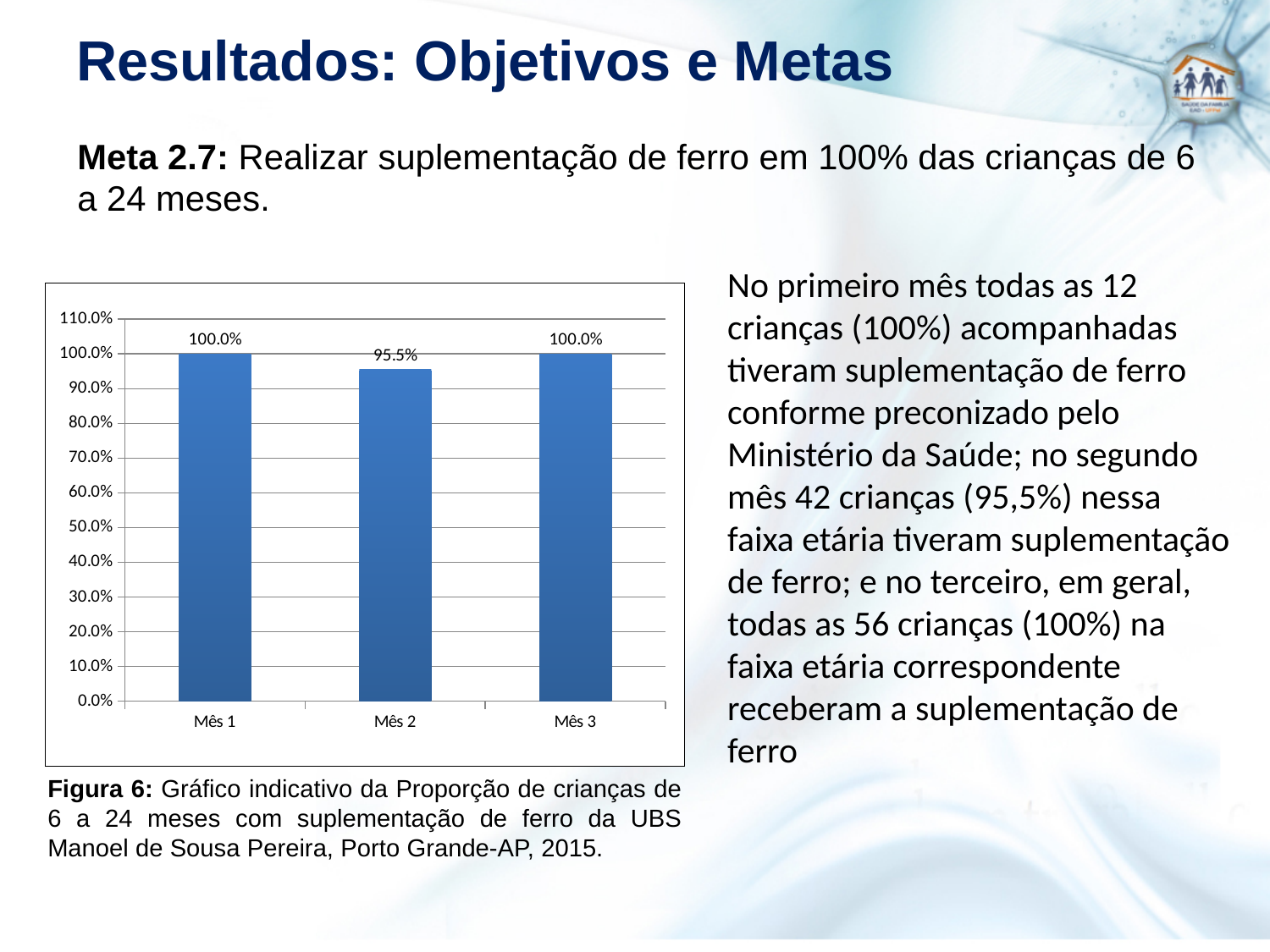
What is the value for Mês 1? 100.0% Which is larger, the value for Mês 2 or the value for Mês 3? Mês 3 Which month has the lowest value? Mês 2 What is the value for Mês 3? 100.0% What is the highest value shown on the y axis? 110.0% What colour are the bars in the chart? blue What is the value for Mês 2? 95.5% How many months are shown on the x axis? 3 Does the value rise or fall from Mês 1 to Mês 2? fall What kind of chart is shown? bar chart Is the value for Mês 2 greater or less than 90.0%? greater What is the difference between the values for Mês 1 and Mês 2? 4.5%